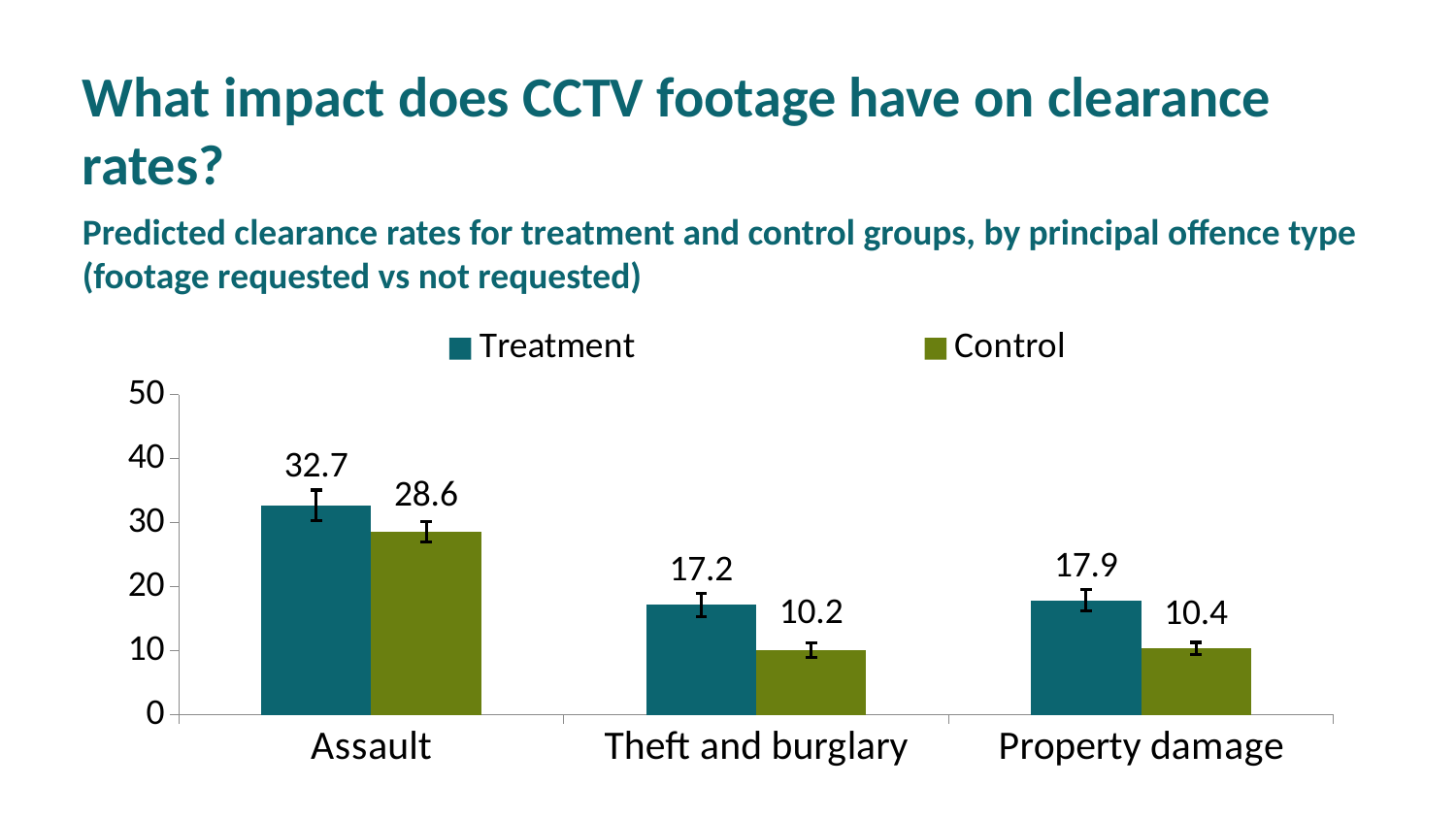
What is the Treatment value for Property damage? 17.9 How many series does the legend list? 2 Which offence type has the lowest Treatment value? Theft and burglary What is the difference between the Treatment and Control values for Assault? 4.1 Which offence type has the highest Control value? Assault What is the Treatment value for Assault? 32.7 Which is larger for Property damage, the Treatment value or the Control value? Treatment What kind of chart is shown on the slide? Bar chart How many offence types are shown on the x axis? 3 What is the difference between the Treatment and Control values for Theft and burglary? 7.0 What is the Control value for Theft and burglary? 10.2 Which series is shown in green? Control